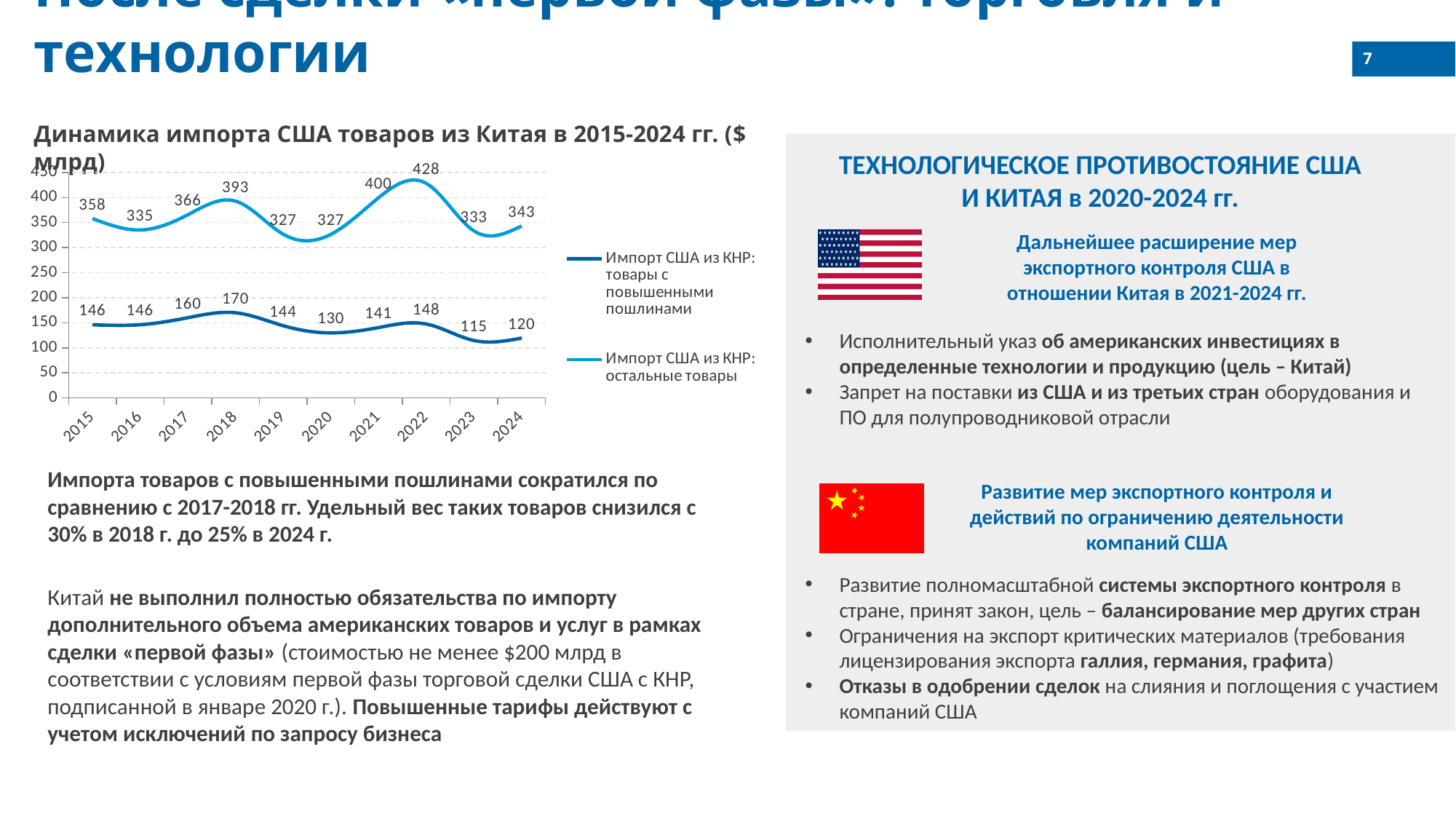
Does the series "Импорт США из КНР: товары с повышенными пошлинами" rise or fall from 2022 to 2023? fall What is the value for 2018 in the series "Импорт США из КНР: товары с повышенными пошлинами"? 170 What kind of chart is shown on the slide? line chart What is the difference between the 2018 and 2024 values of the series "Импорт США из КНР: товары с повышенными пошлинами"? 50 How many years are plotted on the x axis of the chart? 10 How many series does the chart legend list? 2 What is the value for 2022 in the series "Импорт США из КНР: остальные товары"? 428 In which year does the series "Импорт США из КНР: остальные товары" reach its highest value? 2022 Is the 2020 value of the series "Импорт США из КНР: остальные товары" greater or less than 350? less Which is larger: the 2021 value or the 2023 value of the series "Импорт США из КНР: остальные товары"? 2021 In which year does the series "Импорт США из КНР: товары с повышенными пошлинами" reach its lowest value? 2023 What is the title of the chart? Динамика импорта США товаров из Китая в 2015-2024 гг. ($ млрд)